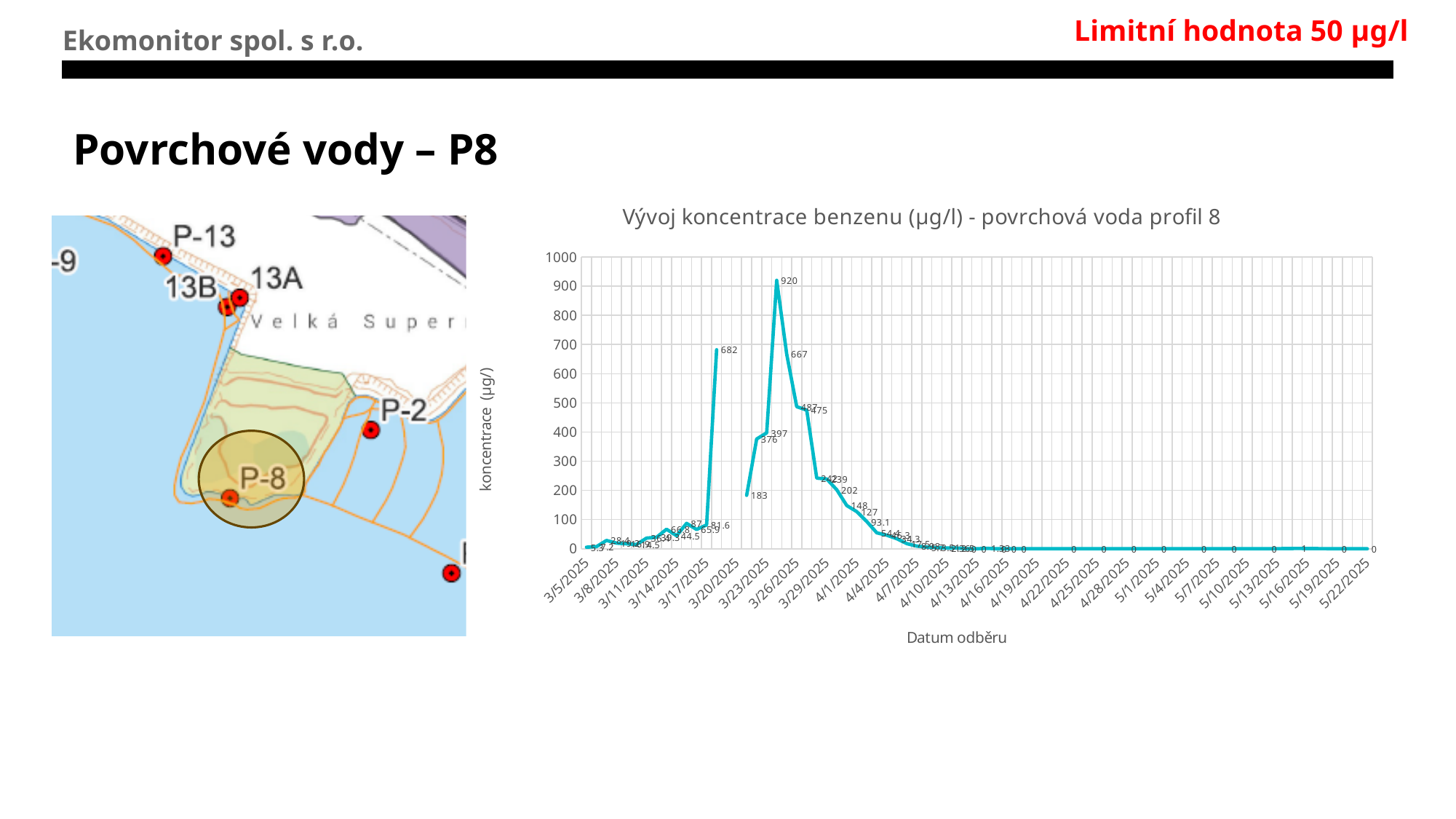
How many date labels are shown on the horizontal axis? 27 What is the highest tick value shown on the vertical axis? 1000 What is the highest benzene concentration value labeled on the chart? 920 What kind of chart is shown on the slide? line chart Is the highest value reached before 3/20/2025 larger or smaller than the highest value reached after 3/20/2025? smaller Is the peak value on the chart greater or less than 900? greater What is the title of the chart? Vývoj koncentrace benzenu (µg/l) - povrchová voda profil 8 After the peak of 920, do the values rise or fall toward the end of the x axis? fall What is the label of the vertical axis of the chart? koncentrace (µg/l) What is the difference between the highest labeled value (920) and the value labeled 682? 238 What is the value labeled at the last date, 5/22/2025? 0 Is the value for 4/7/2025 greater or less than 100? less